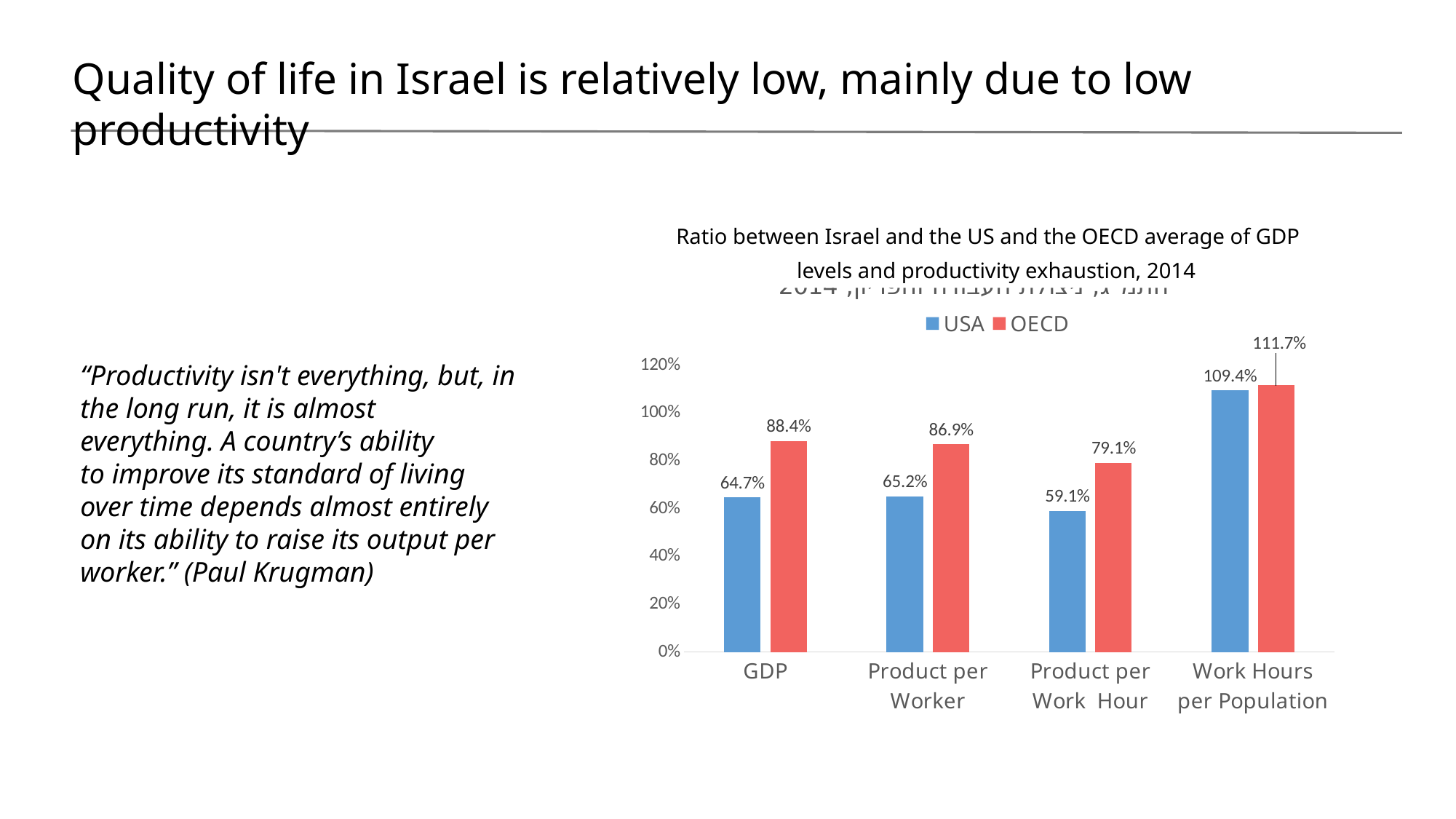
What is the USA value for GDP? 64.7% What is the OECD value for Work Hours per Population? 111.7% What is the difference between the OECD and USA values for GDP? 23.7% Which category has the lowest USA value? Product per Work Hour What is the USA value for Product per Worker? 65.2% Which category has the highest OECD value? Work Hours per Population What kind of chart is shown on the slide? Bar chart How many series does the legend list? 2 How many categories are shown on the x axis? 4 Which colour represents the OECD series? Red What is the OECD value for Product per Work Hour? 79.1% Which is larger for Product per Work Hour, the USA value or the OECD value? OECD